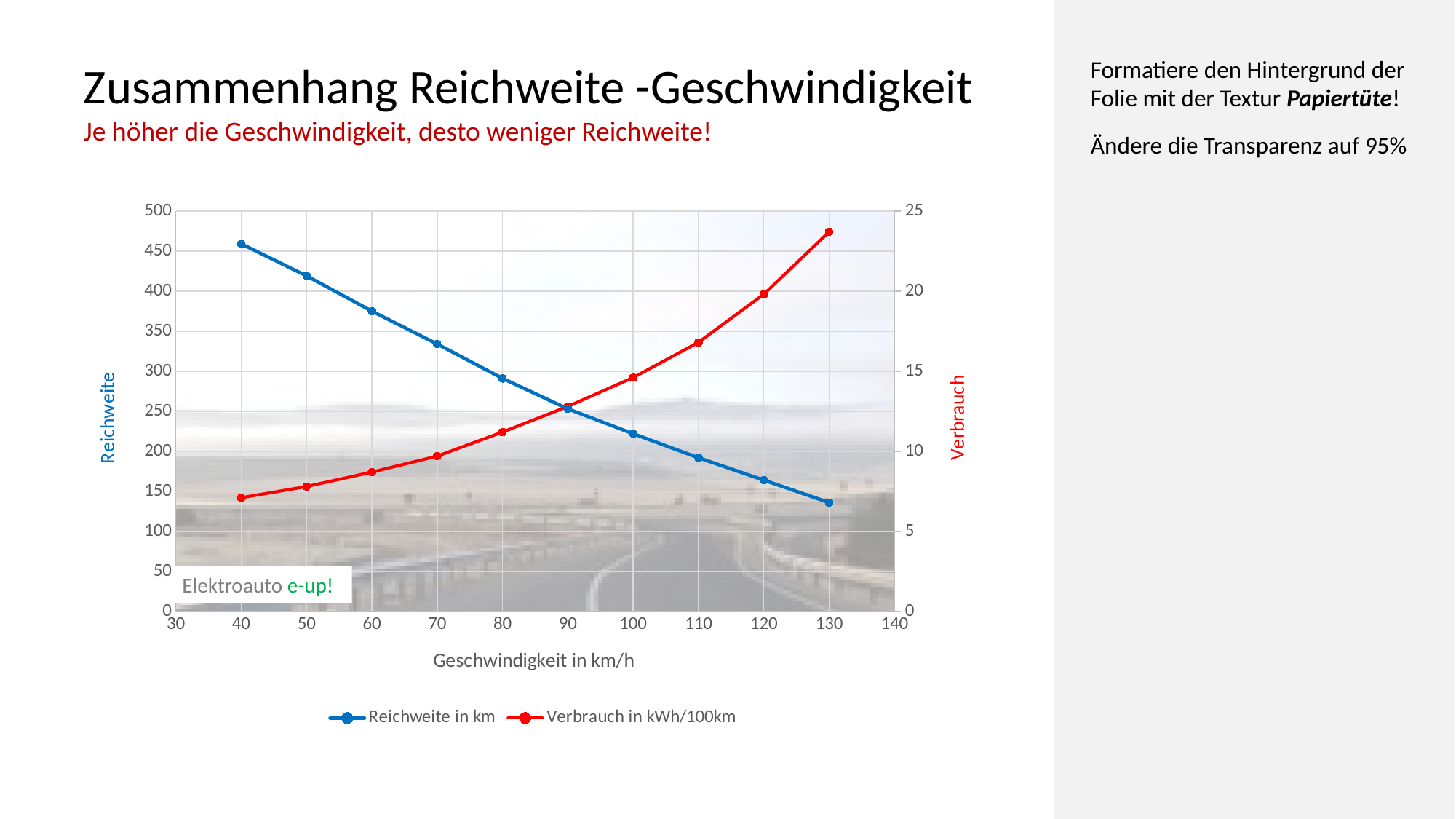
At which speed (Geschwindigkeit) is the Verbrauch in kWh/100km lowest? 40 Is the Reichweite in km at 130 km/h greater or less than 150? less How many series does the chart legend list? 2 At which speed (Geschwindigkeit) is the Reichweite in km highest? 40 Is the Reichweite in km at 60 km/h greater or less than 350? greater Does the Reichweite in km rise or fall as the Geschwindigkeit increases? fall What is the title of the x axis of the chart? Geschwindigkeit in km/h Does the Verbrauch in kWh/100km rise or fall as the Geschwindigkeit increases? rise At which speed (Geschwindigkeit) is the Verbrauch in kWh/100km highest? 130 Is the Verbrauch in kWh/100km at 130 km/h greater or less than 20? greater How many data points are plotted for the series Reichweite in km? 10 What kind of chart is shown on the slide? line chart